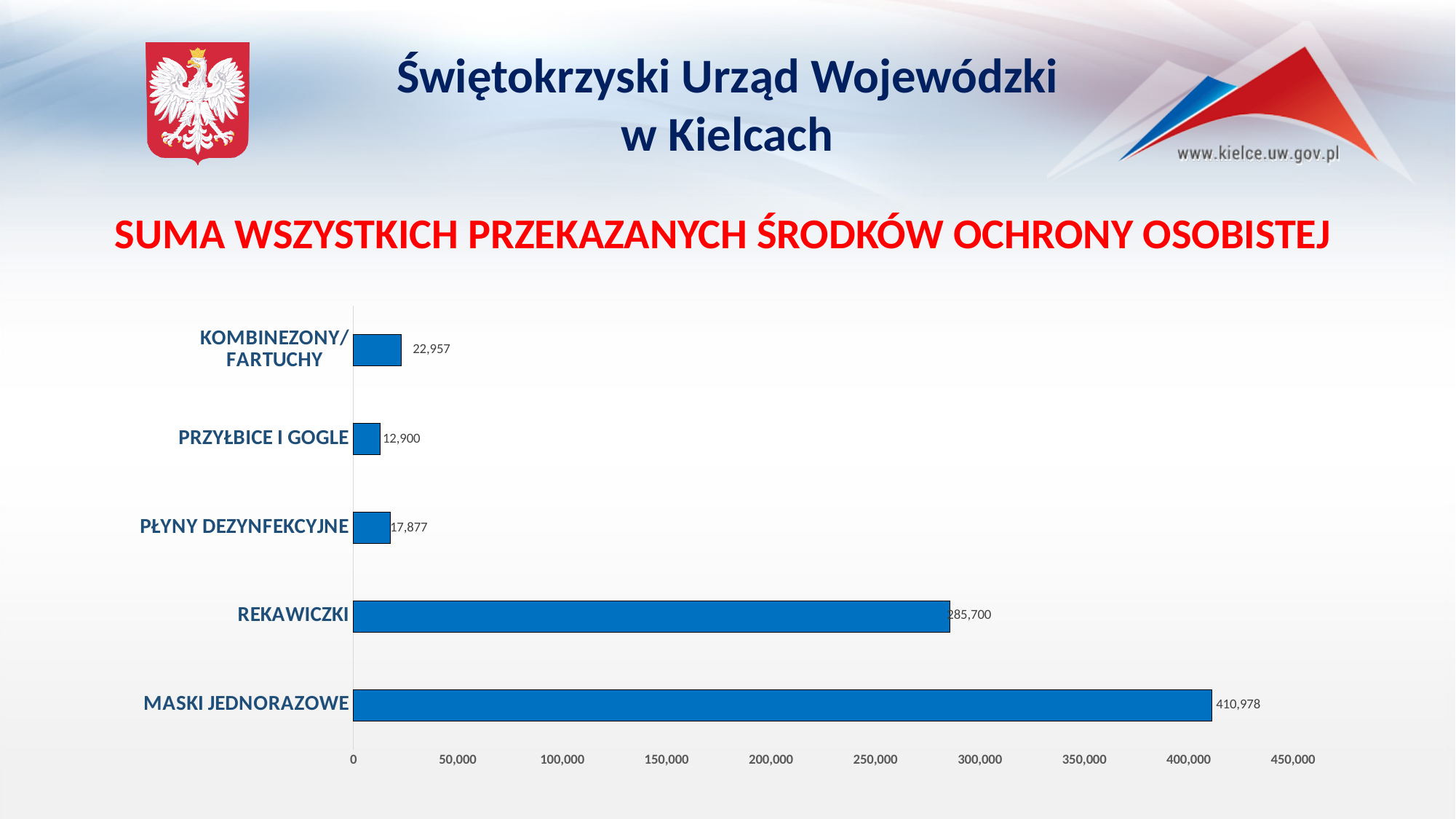
What is the value for PRZYŁBICE I GOGLE? 12,900 What is the difference between the values for MASKI JEDNORAZOWE and REKAWICZKI? 125,278 What is the value for KOMBINEZONY/FARTUCHY? 22,957 What is the difference between the values for KOMBINEZONY/FARTUCHY and PRZYŁBICE I GOGLE? 10,057 How many categories are shown in the chart? 5 What is the value for REKAWICZKI? 285,700 What kind of chart is shown on the slide? Bar chart Which category has the lowest value? PRZYŁBICE I GOGLE What is the value for MASKI JEDNORAZOWE? 410,978 Which category has the highest value? MASKI JEDNORAZOWE Which is larger, the value for KOMBINEZONY/FARTUCHY or the value for PŁYNY DEZYNFEKCYJNE? KOMBINEZONY/FARTUCHY What is the value for PŁYNY DEZYNFEKCYJNE? 17,877